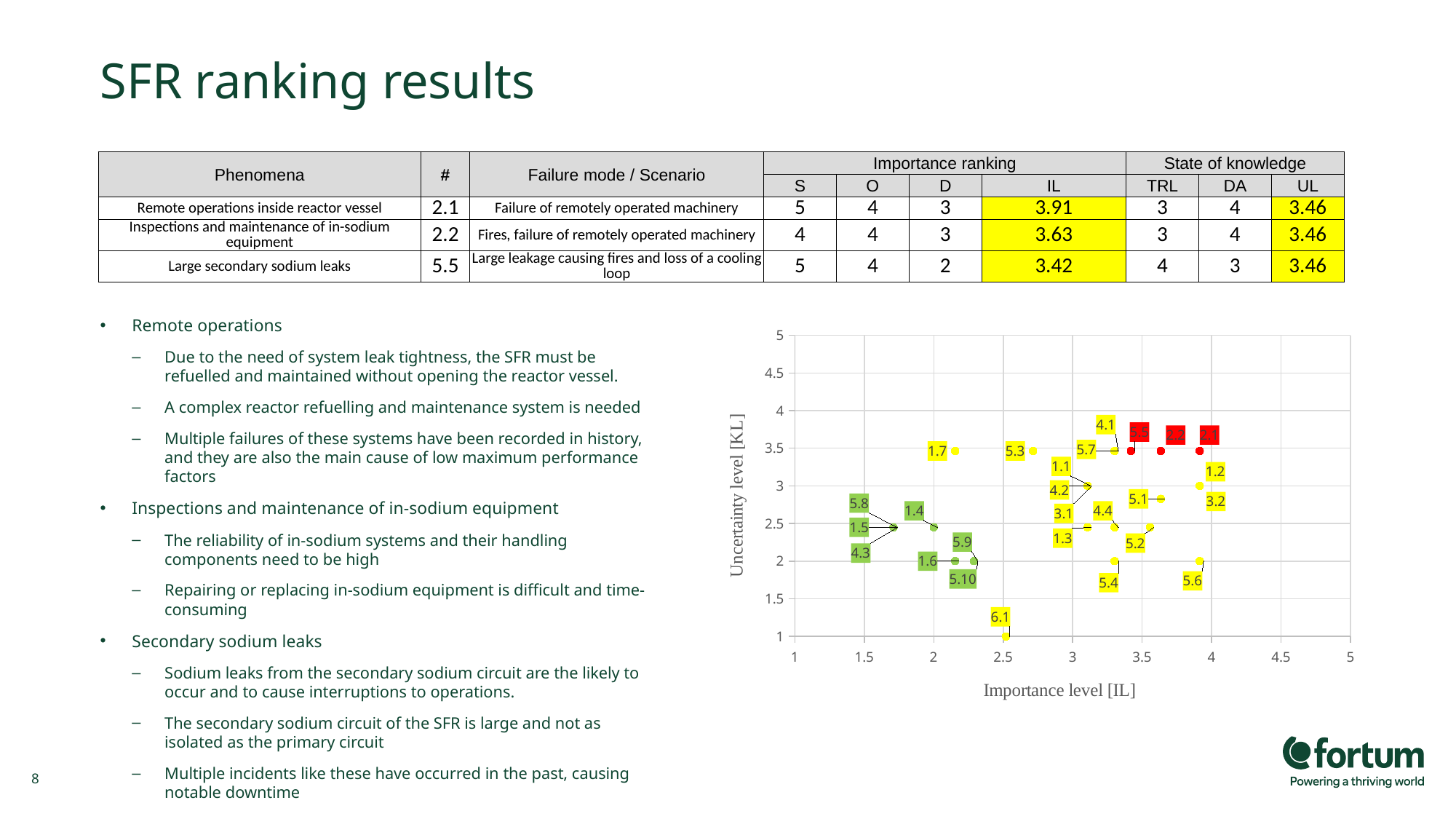
Which point has a higher importance level, 2.1 or 5.5? 2.1 What kind of chart is shown on the slide? scatter chart Is the uncertainty level for point 5.6 greater or less than 2.5? less Is the uncertainty level for point 1.7 greater or less than 3? greater How many points in the chart are marked in red? 3 What is the title of the x axis of the chart? Importance level [IL] Is the uncertainty level for point 6.1 greater or less than 1.5? less Which point has a higher uncertainty level, 1.2 or 5.6? 1.2 Which labelled point has the lowest uncertainty level in the chart? 6.1